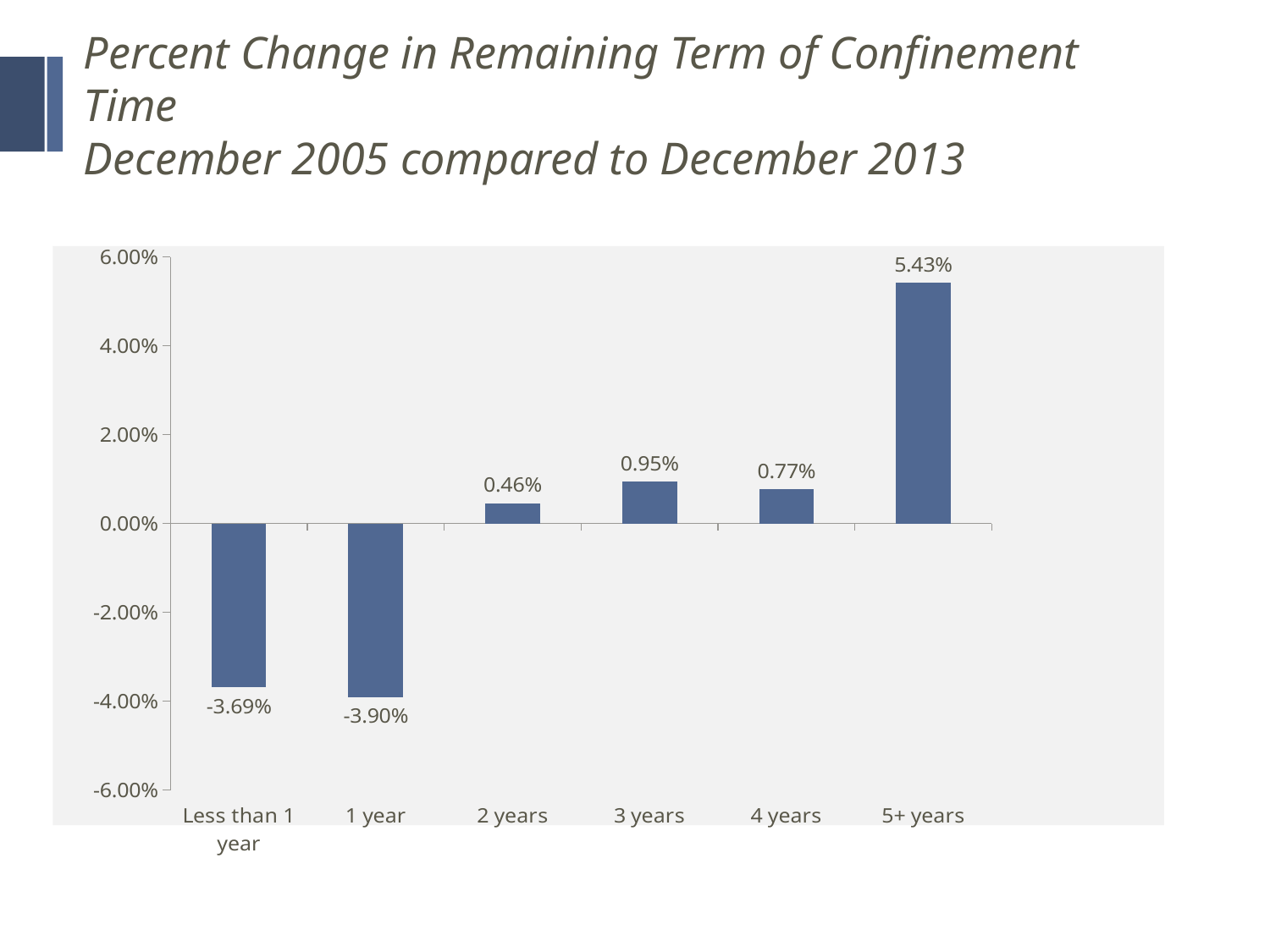
How many categories are shown on the x axis? 6 What is the difference between the percent change for 3 years and for 4 years? 0.18% What is the percent change for the 1 year category? -3.90% What is the percent change for the 5+ years category? 5.43% How many categories have a negative percent change? 2 What is the percent change for the Less than 1 year category? -3.69% What kind of chart is shown on the slide? Bar chart Is the value for 5+ years greater or less than 4.00%? greater What is the percent change for the 3 years category? 0.95% Which is larger, the percent change for 2 years or for 4 years? 4 years Which category has the lowest percent change? 1 year Which category has the highest percent change? 5+ years